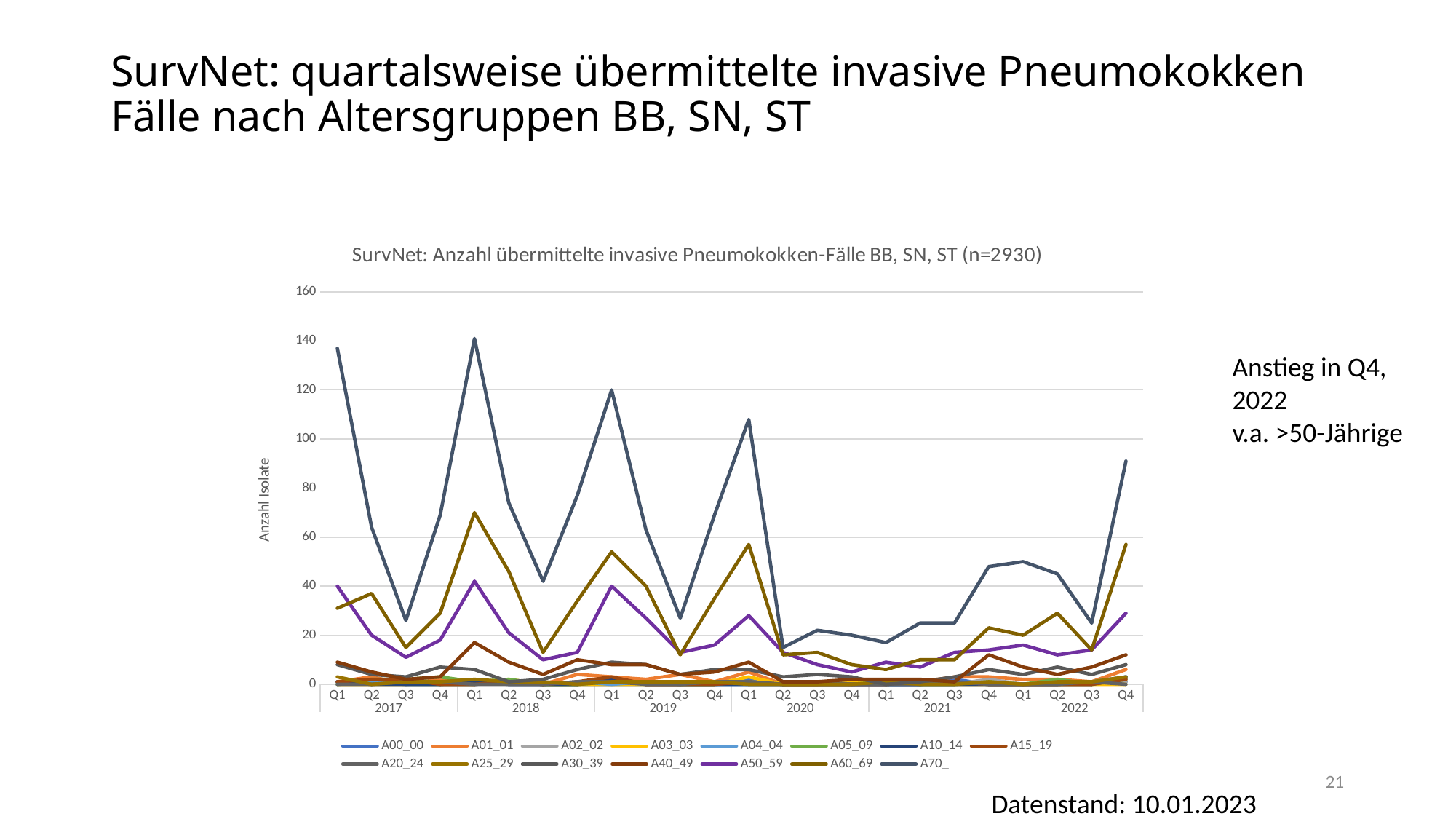
Which is larger for A70_: the value in Q1 2019 or the value in Q1 2020? Q1 2019 Is the value for A70_ in Q1 2017 greater or less than 120? greater Which series has the highest value in Q1 2018? A70_ Does the A70_ line rise or fall from Q3 2022 to Q4 2022? rise What is the label of the vertical axis? Anzahl Isolate How many quarters (x-axis points) are plotted in the chart? 24 How many series does the chart legend list? 15 What kind of chart is shown on the slide? line chart Is the value for A70_ in Q4 2022 greater or less than 80? greater Is the value for A70_ in Q1 2020 greater or less than 100? greater What total number of cases (n) is given in the chart title? n=2930